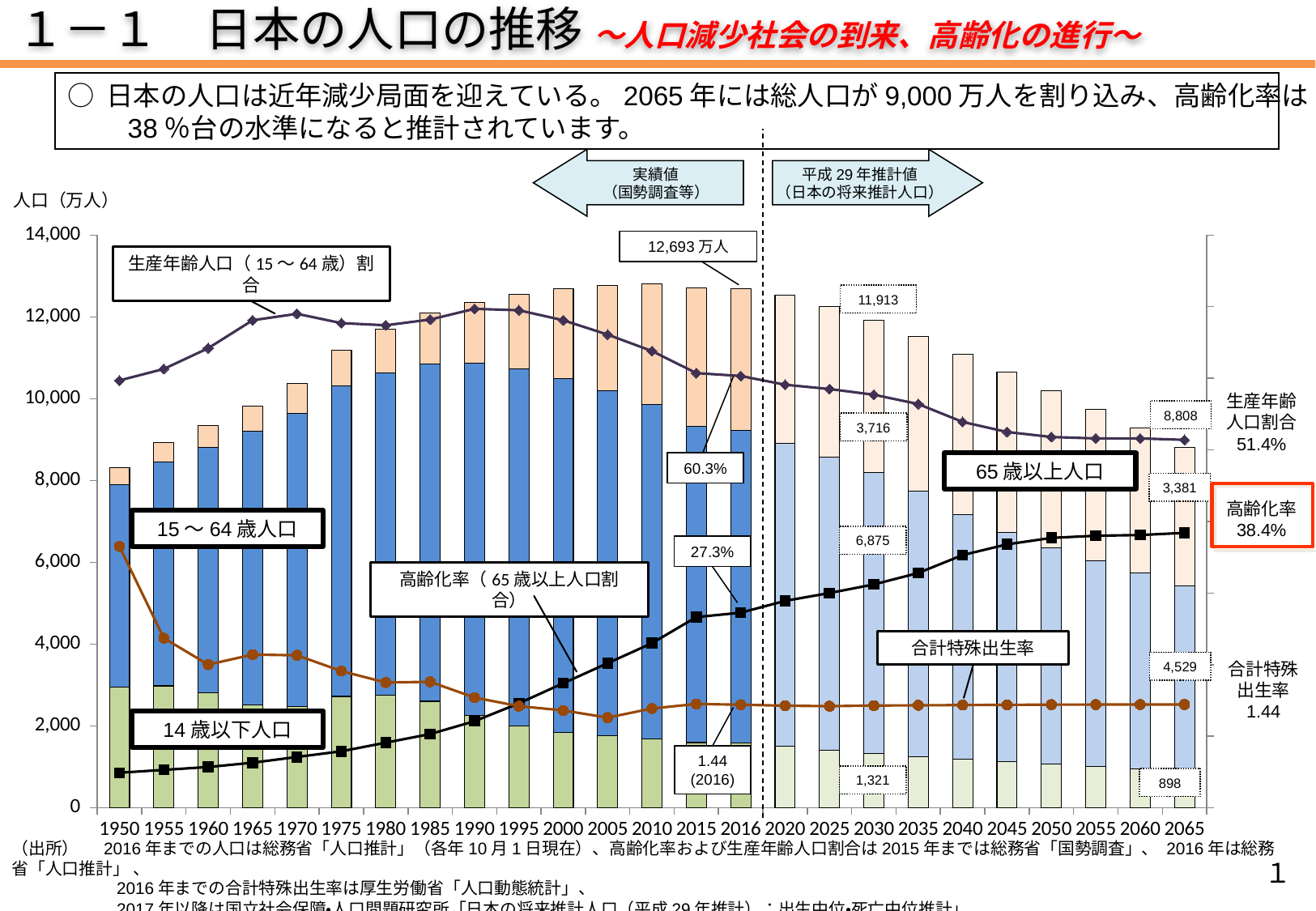
What is the 高齢化率 shown for 2065? 38.4% What is the total population labelled for 2065? 8,808 What type of chart is shown on the slide? Combined stacked bar and line chart What is the 65歳以上人口 value labelled for 2065? 3,381 What is the 15～64歳人口 value labelled for 2030? 6,875 What is the total population labelled for 2030? 11,913 Which is larger, the 65歳以上人口 labelled for 2030 or for 2065? 2030 By how much does the total population labelled for 2016 exceed that labelled for 2065? 3,885 What is the 生産年齢人口割合 shown for 2016? 60.3% Does the 高齢化率 line rise or fall from 1950 to 2065? rise What is the total population labelled for 2016? 12,693万人 Is the total population bar for 1950 greater or less than 8,000? greater